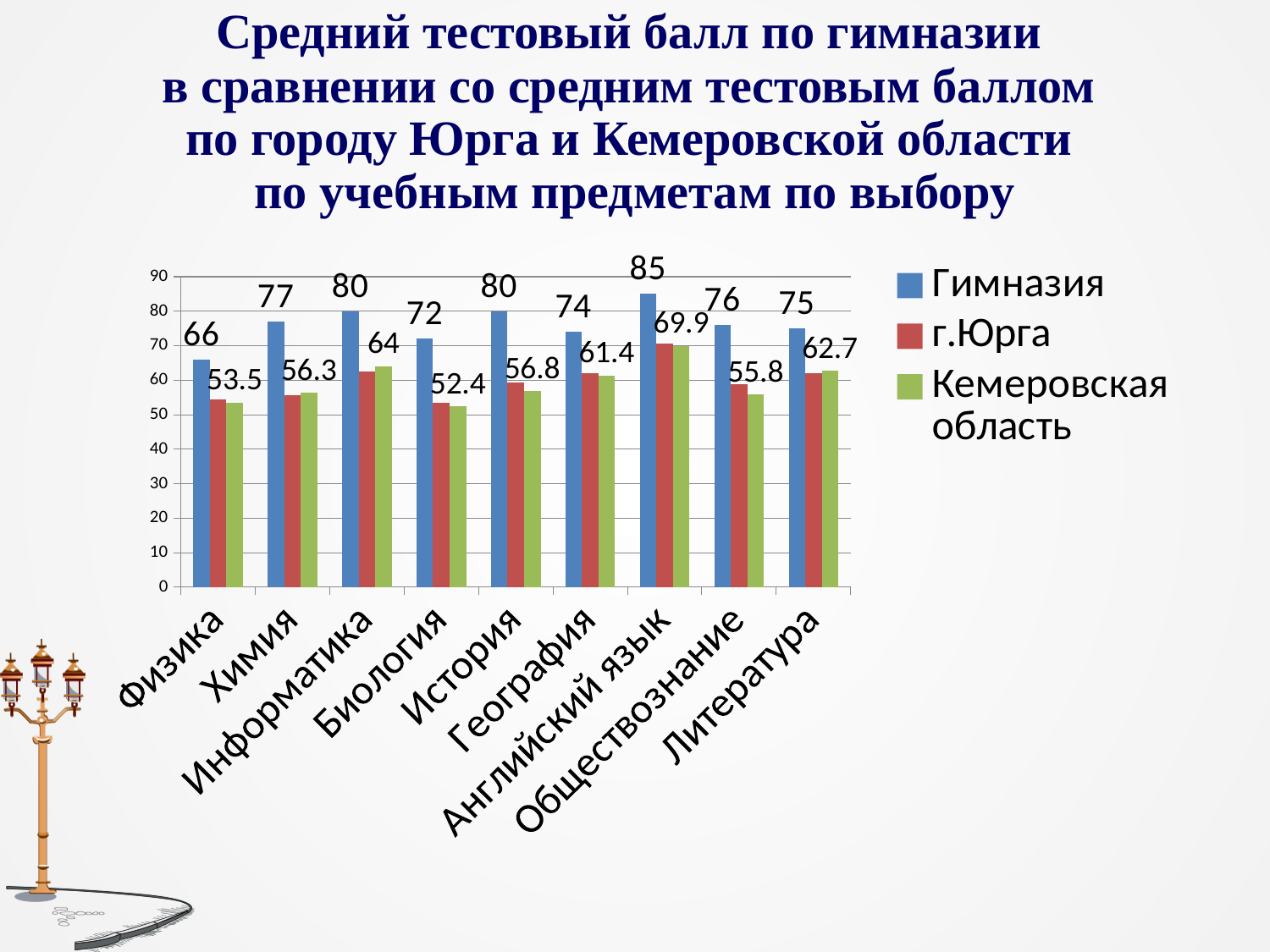
How many subjects are shown on the x axis? 9 What is the difference between the Гимназия and Кемеровская область values for Информатика? 16 How many series does the legend list? 3 Which is larger for Гимназия: Химия or Информатика? Информатика What is the value for Гимназия in Английский язык? 85 What is the value for Кемеровская область in Информатика? 64 Which subject has the lowest value for Гимназия? Физика Which subject has the lowest value for Кемеровская область? Биология What is the value for Кемеровская область in Биология? 52.4 What is the value for Гимназия in Физика? 66 Which subject has the highest value for Гимназия? Английский язык Is the value for г.Юрга in Физика greater or less than 60? less